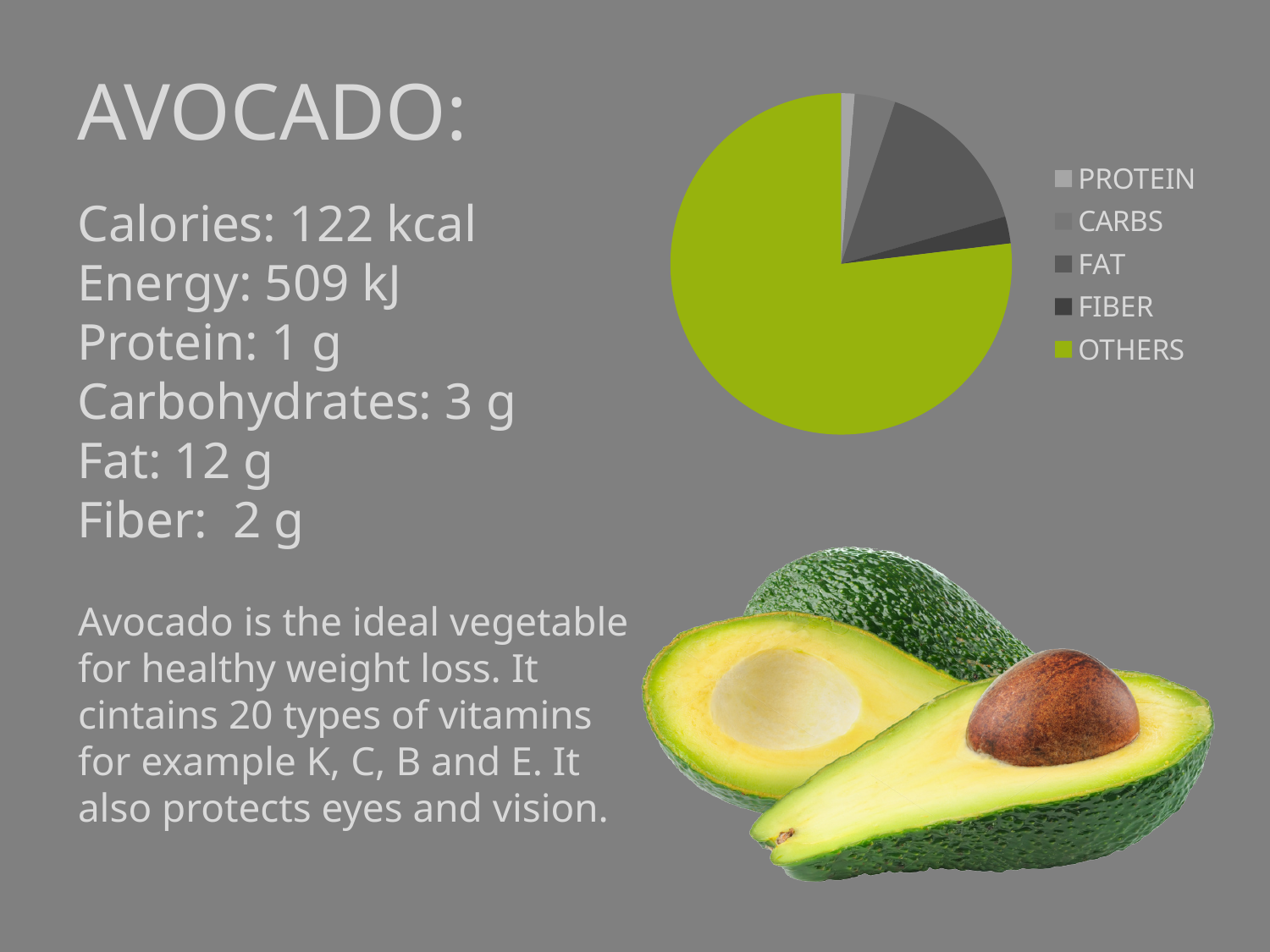
Which category has the smallest slice of the pie chart? PROTEIN Which legend entry is listed last in the pie chart legend? OTHERS Which slice is larger in the pie chart, OTHERS or FAT? OTHERS What colour is the OTHERS slice in the pie chart? green How many entries does the chart legend list? 5 How many slices does the pie chart have? 5 Which slice is larger in the pie chart, FAT or CARBS? FAT Which slice is larger in the pie chart, FAT or FIBER? FAT What kind of chart is shown on the slide? pie chart Which category has the largest slice of the pie chart? OTHERS